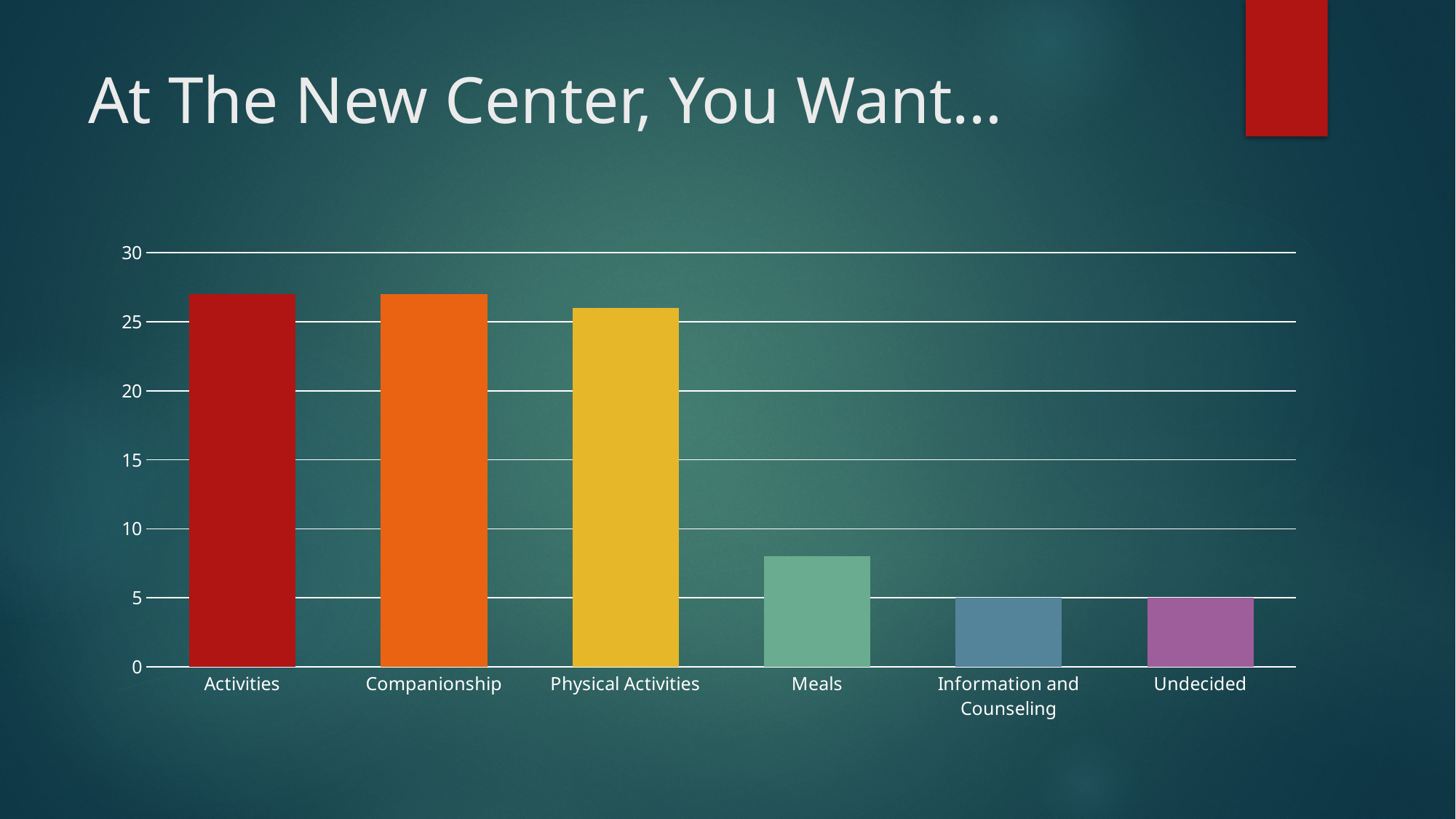
What is the title of the slide containing the chart? At The New Center, You Want... How many categories are shown on the x axis of the chart? 6 Which is larger, the value for Meals or the value for Undecided? Meals What is the value for Undecided? 5 Which is larger, the value for Activities or the value for Meals? Activities Which is larger, the value for Physical Activities or the value for Information and Counseling? Physical Activities Is the value for Meals greater or less than 10? less What is the value for Information and Counseling? 5 What kind of chart is shown on the slide? bar chart Is the value for Physical Activities greater or less than 20? greater Is the value for Activities greater or less than 25? greater